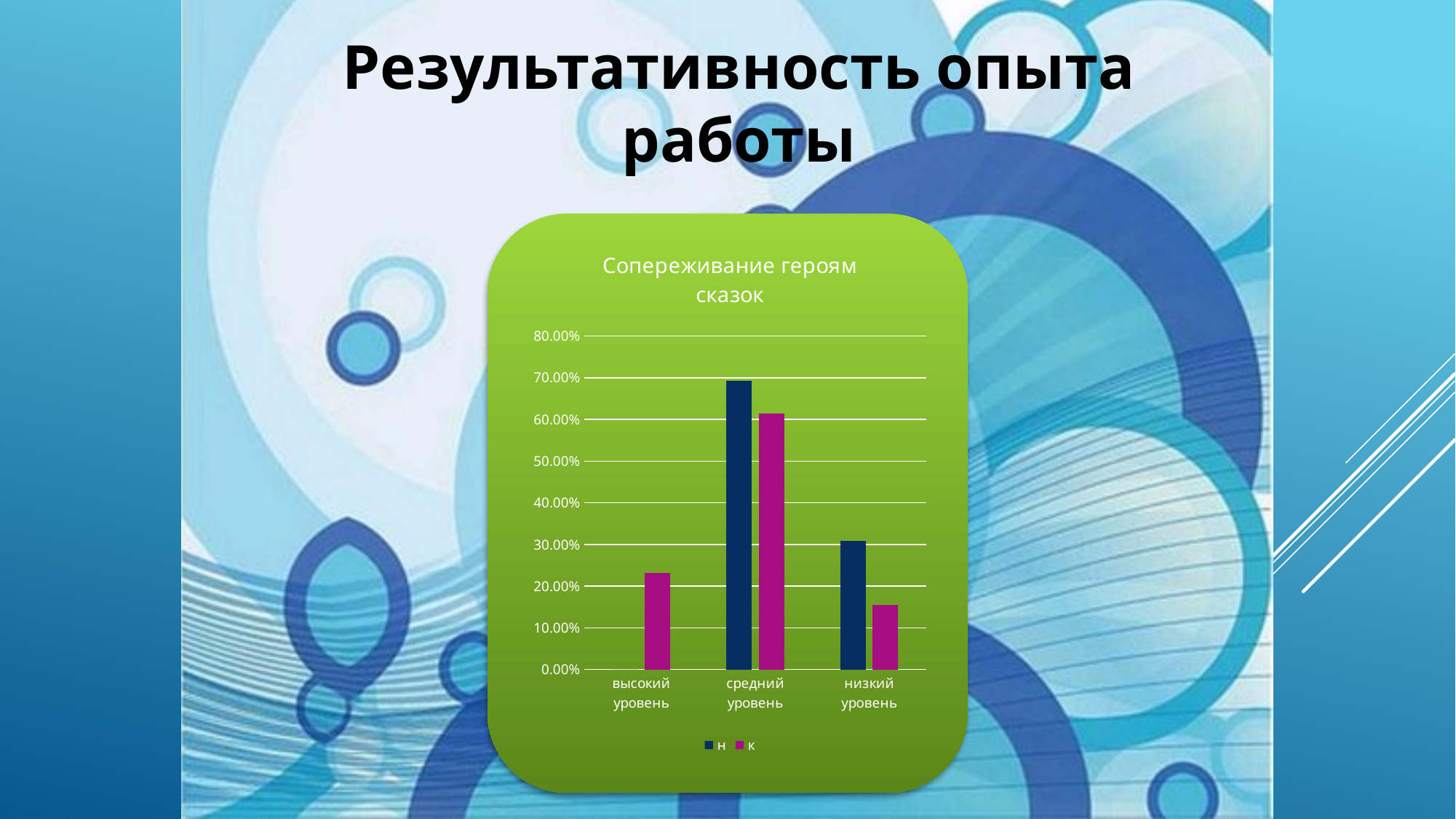
For низкий уровень, which series has the larger value, н or к? н How many series does the chart legend list? 2 Which category has the highest value for series н? средний уровень Which category has the lowest value for series к? низкий уровень What is the title of the chart? Сопереживание героям сказок What are the two series names in the chart legend? н and к Which category has the highest value for series к? средний уровень How many categories are shown on the x axis of the chart? 3 Is the value for series н at средний уровень greater or less than 60.00%? greater What kind of chart is shown on the slide? bar chart Is the value for series к at высокий уровень greater or less than 20.00%? greater For средний уровень, which series has the larger value, н or к? н